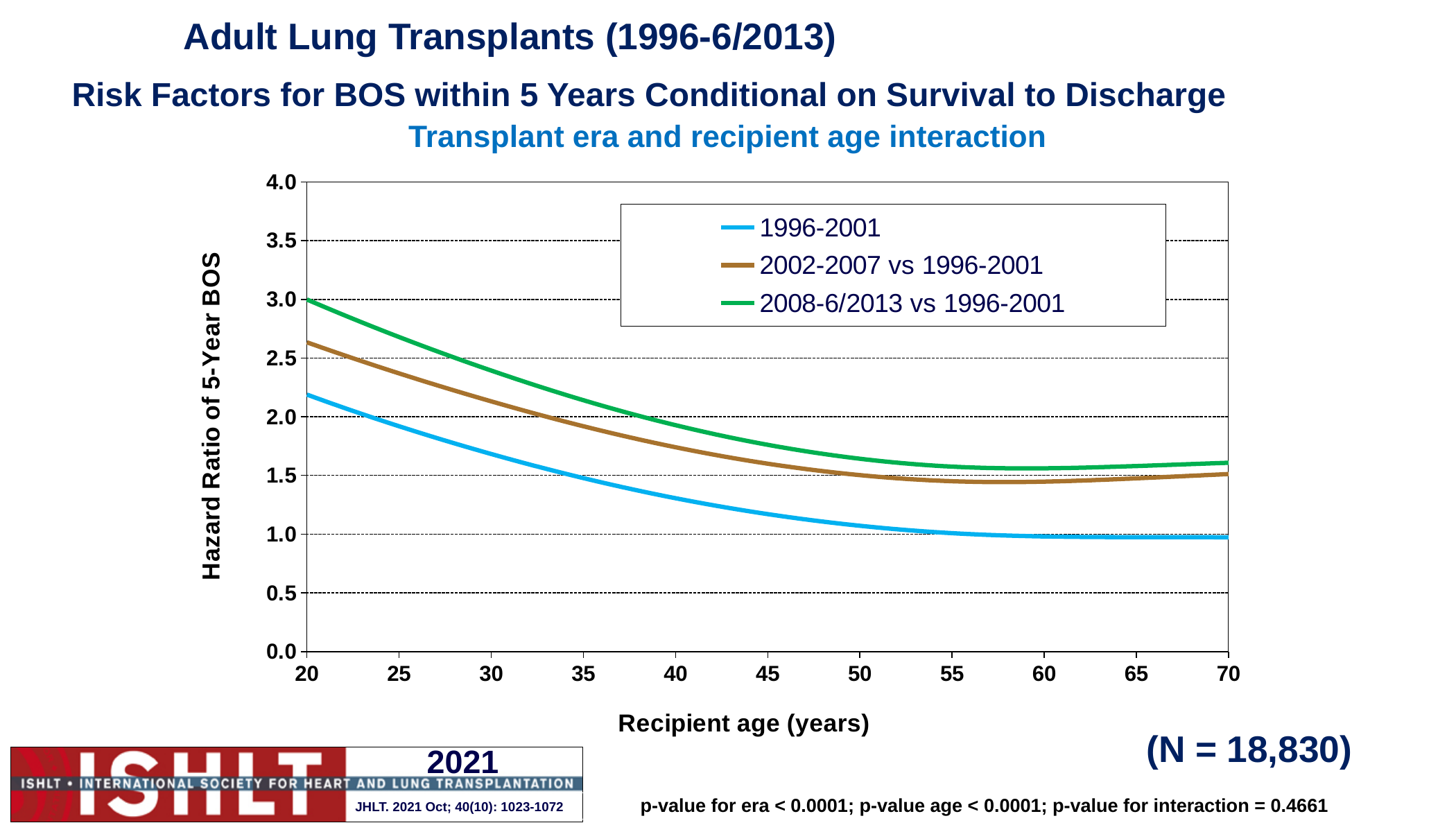
How many series does the legend list? 3 What is the label of the x axis? Recipient age (years) Is the hazard ratio for the 1996-2001 series at recipient age 40 greater or less than 1.5? less Is the hazard ratio for the 2002-2007 vs 1996-2001 series at recipient age 40 greater or less than 2.0? less Does the hazard ratio for the 1996-2001 series rise or fall as recipient age increases from 20 to 50? fall Is the hazard ratio for the 2008-6/2013 vs 1996-2001 series at recipient age 25 greater or less than 2.5? greater What kind of chart is shown on the slide? line chart Which series has the lowest hazard ratio at recipient age 40? 1996-2001 Which series has the highest hazard ratio at recipient age 20? 2008-6/2013 vs 1996-2001 At recipient age 30, which series has the larger hazard ratio: 2008-6/2013 vs 1996-2001 or 1996-2001? 2008-6/2013 vs 1996-2001